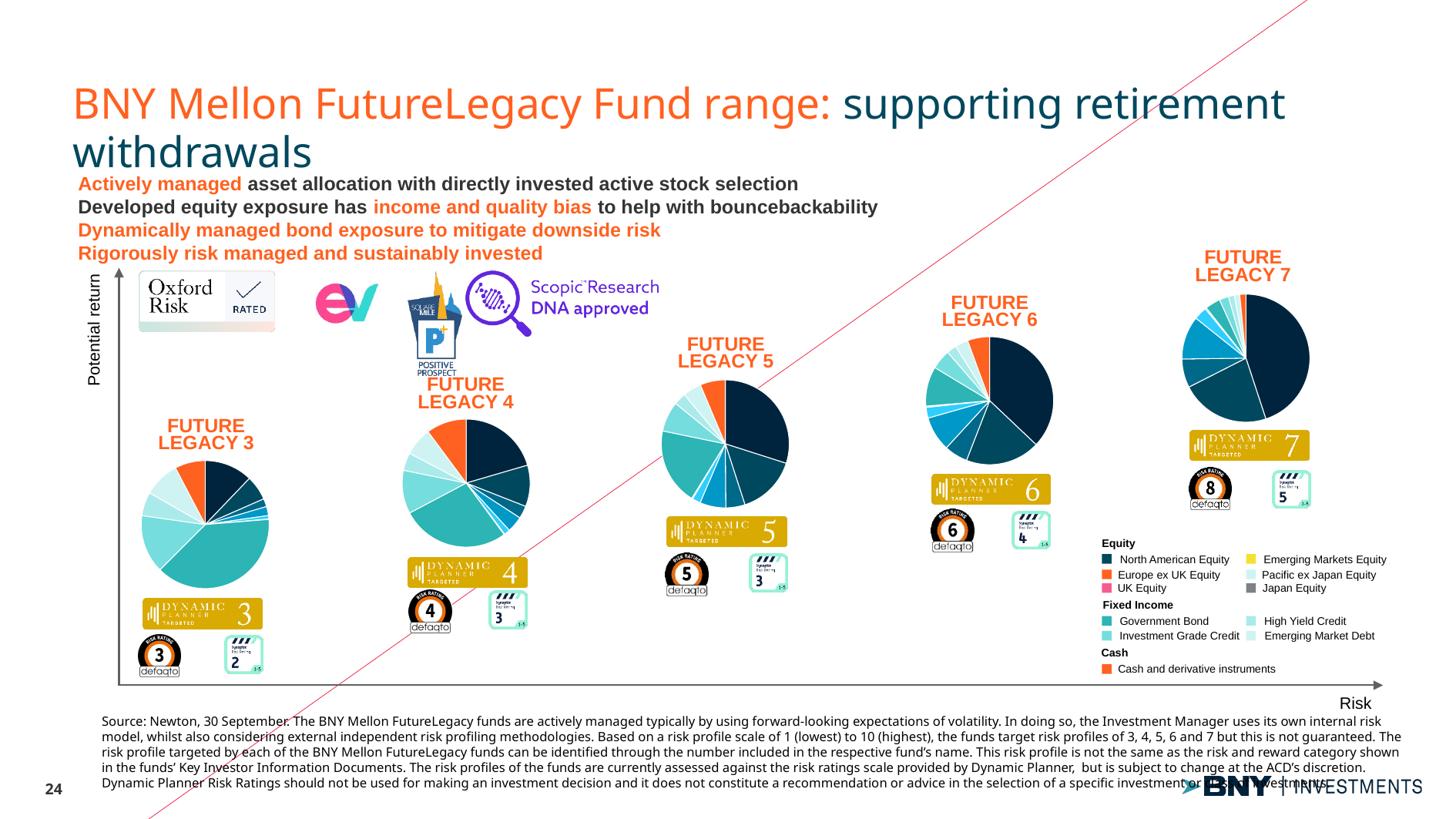
What is the label on the horizontal axis of the chart area? Risk Is the North American Equity share larger in the Future Legacy 7 pie chart or the Future Legacy 3 pie chart? Future Legacy 7 Which fund's pie chart has the smallest share of North American Equity? Future Legacy 3 How many categories does the legend list under Equity? 6 How many asset categories does the legend list in total? 11 In the Future Legacy 6 pie chart, which asset category has the largest slice? North American Equity In the Future Legacy 7 pie chart, which asset category has the largest slice? North American Equity How many categories does the legend list under Fixed Income? 4 What kind of charts are used to show the asset allocation of the FutureLegacy funds? Pie charts How many pie charts are shown on the slide? 5 Moving from Future Legacy 3 to Future Legacy 7 along the risk axis, does the share of North American Equity rise or fall? Rise What is the label on the vertical axis of the chart area? Potential return